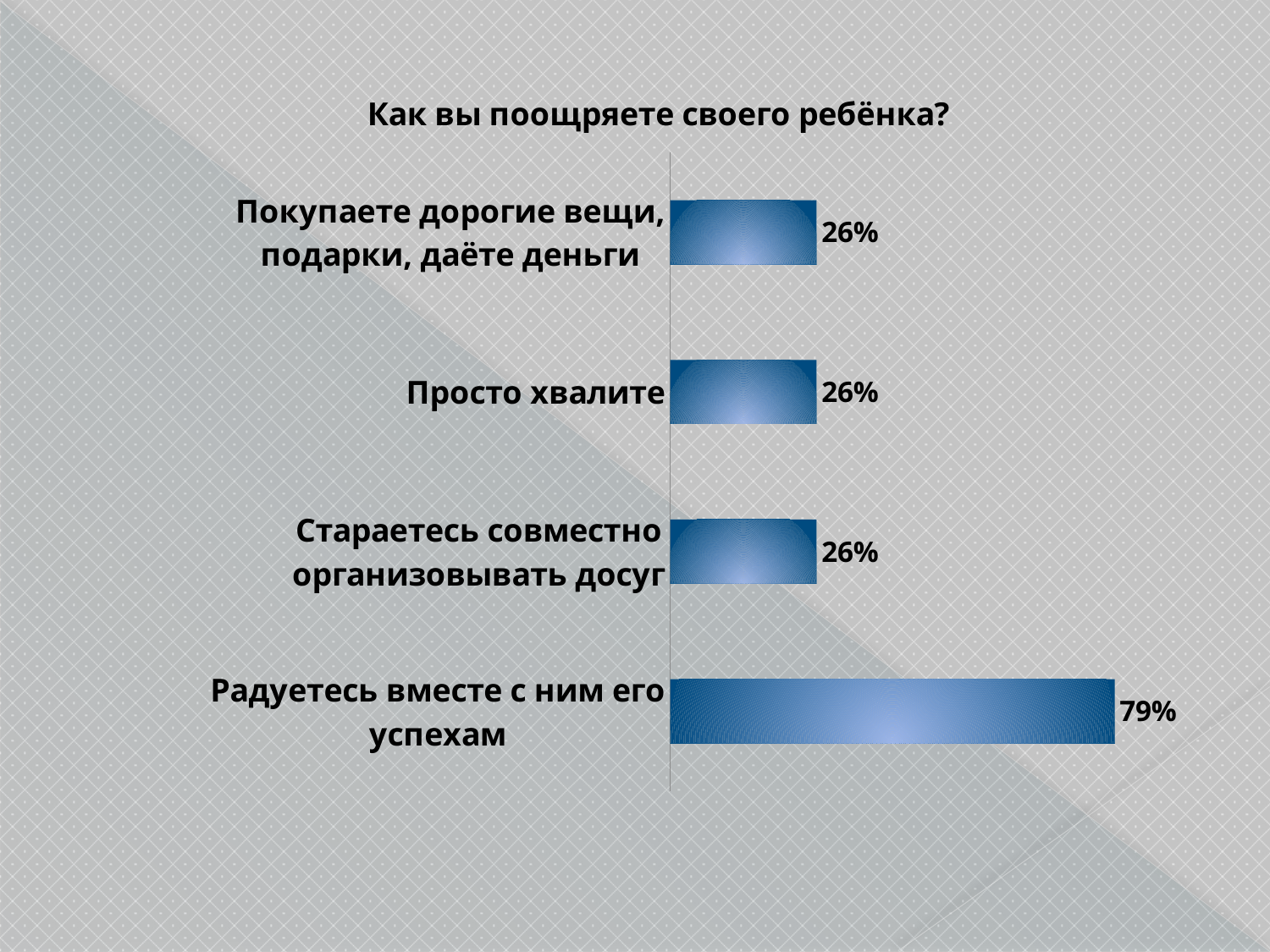
What is the value for "Стараетесь совместно организовывать досуг"? 26% What is the difference between the values for "Радуетесь вместе с ним его успехам" and "Просто хвалите"? 53% Which is larger: the value for "Радуетесь вместе с ним его успехам" or the value for "Покупаете дорогие вещи, подарки, даёте деньги"? Радуетесь вместе с ним его успехам What is the value for "Покупаете дорогие вещи, подарки, даёте деньги"? 26% How many categories are shown in the chart? 4 How many categories share the value 26%? 3 What kind of chart is shown on the slide? Bar chart What is the value for "Радуетесь вместе с ним его успехам"? 79% What colour are the bars in the chart? Blue Which category has the highest value? Радуетесь вместе с ним его успехам What is the value for "Просто хвалите"? 26% What is the title of the chart? Как вы поощряете своего ребёнка?